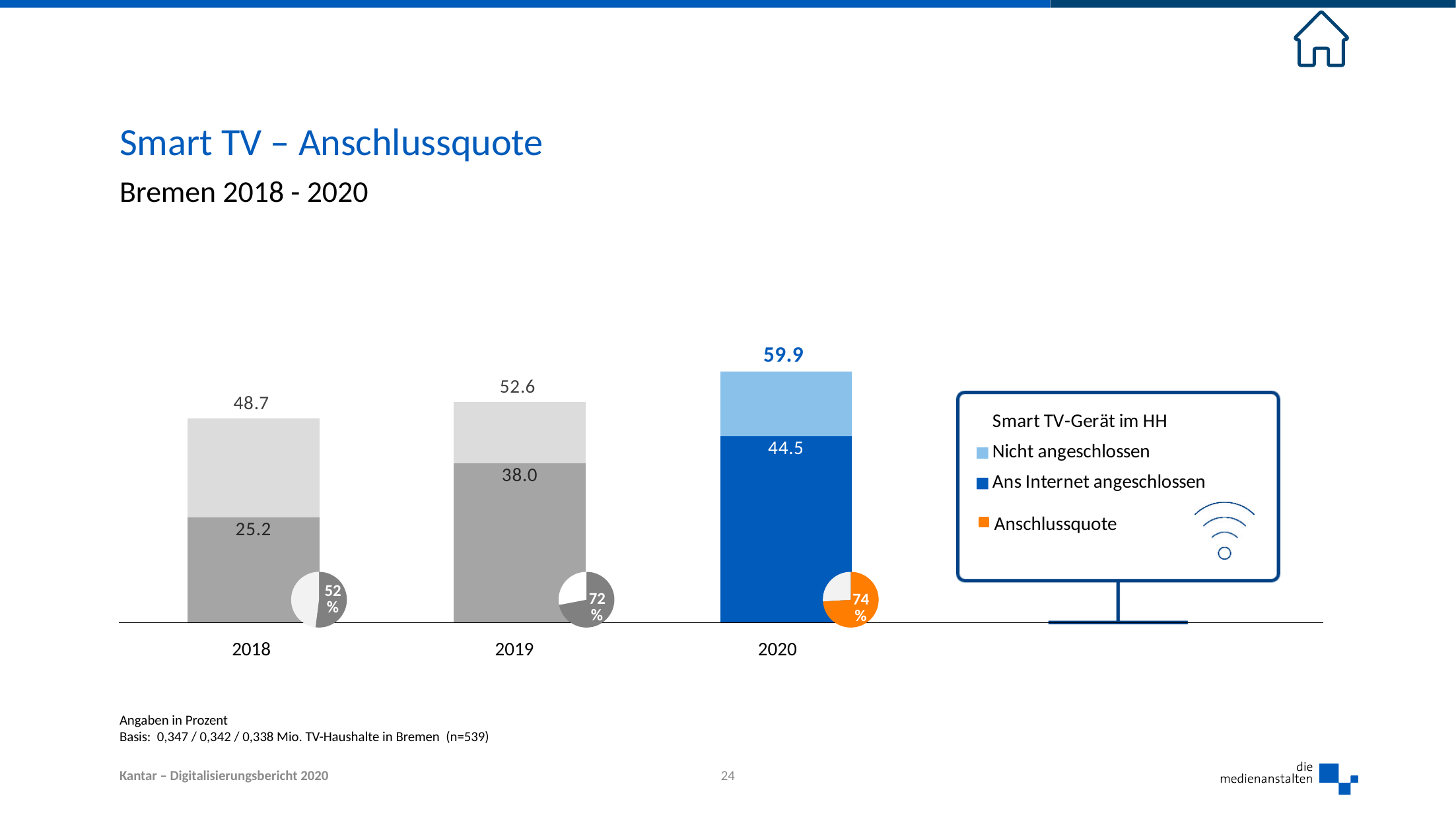
What is the total value of the bar for 2019? 52.6 Do the total bar values rise or fall from 2018 to 2020? Rise What is the value for 'Ans Internet angeschlossen' in 2020? 44.5 How many entries does the legend list? 3 What kind of chart is shown on the slide? Stacked bar chart Which year has the lowest value for 'Ans Internet angeschlossen'? 2018 Which year has the highest total bar value? 2020 Which year has the higher Anschlussquote, 2019 or 2020? 2020 What is the difference between the total bar values for 2020 and 2018? 11.2 What is the Anschlussquote shown for 2018? 52% How many years are shown on the x axis? 3 By how much did the 'Ans Internet angeschlossen' value increase from 2018 to 2019? 12.8